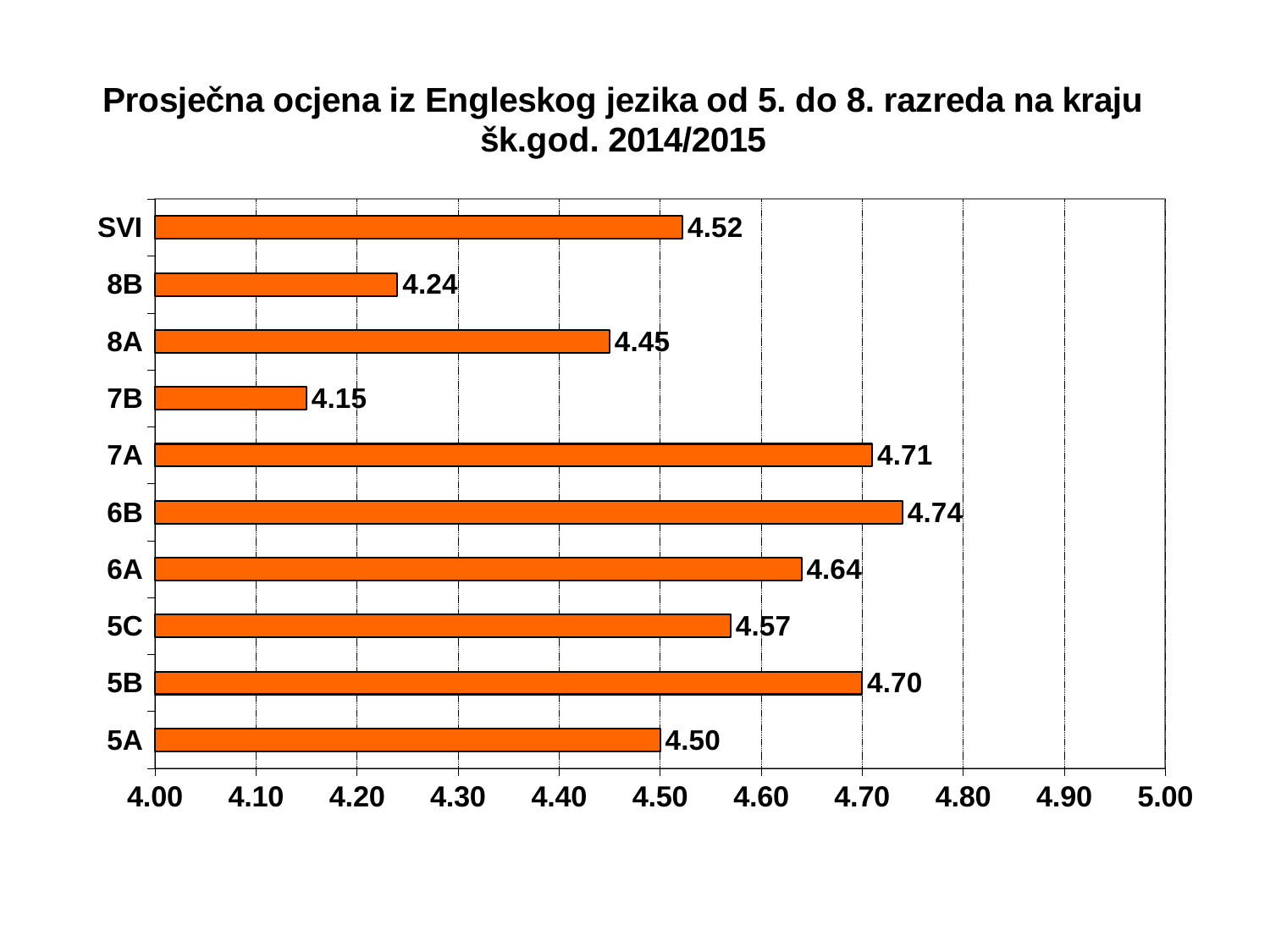
What is the average English grade for class 6B? 4.74 Which class has the highest average grade? 6B What colour are the bars in the chart? orange What kind of chart is shown on the slide? bar chart What is the average grade for class 7B? 4.15 Is the value for 8A greater or less than 4.50? less What is the difference between the value for 6A and the value for SVI? 0.12 Which has a higher average grade, 5B or 5C? 5B How many categories are shown on the chart? 10 What is the value shown for SVI? 4.52 What is the difference between the average grades of 7A and 8B? 0.47 Which class has the lowest average grade? 7B